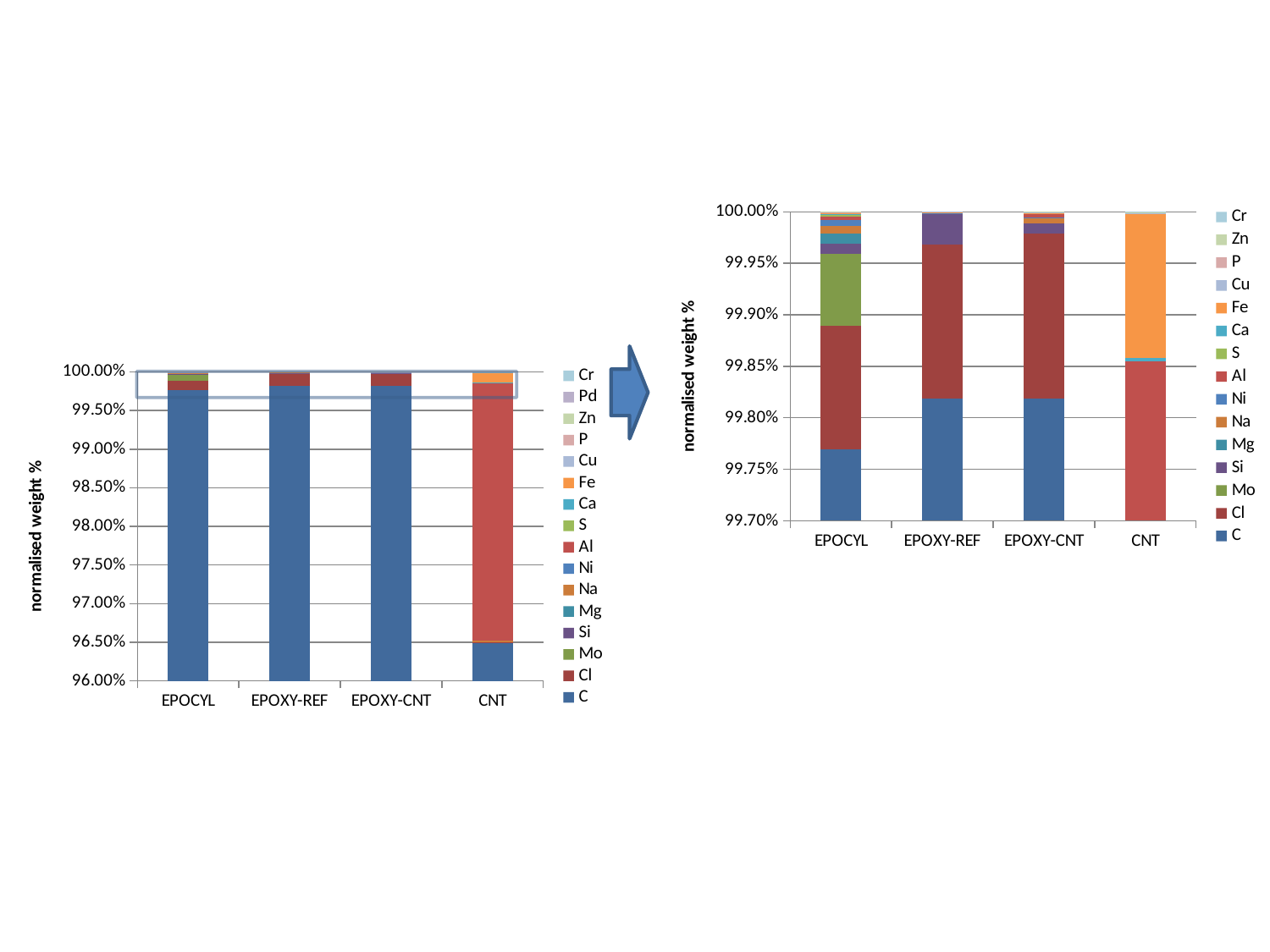
In the right chart, which is larger, the C value for EPOCYL or the C value for EPOXY-REF? EPOXY-REF How many series does the legend of the left chart list? 16 How many categories are shown on the x axis of the right chart? 4 What kind of chart is the left chart? stacked bar chart In the right chart, which category has the largest Fe segment? CNT What is the y-axis title of the right chart? normalised weight % How many series does the legend of the right chart list? 15 In the left chart, is the value of C for EPOCYL greater or less than 99.50%? greater In the right chart, which category has the largest Mo segment? EPOCYL What is the lowest value shown on the y axis of the right chart? 99.70% In the left chart, which category has the largest Al segment? CNT In the right chart, is the value of C for EPOCYL greater or less than 99.80%? less